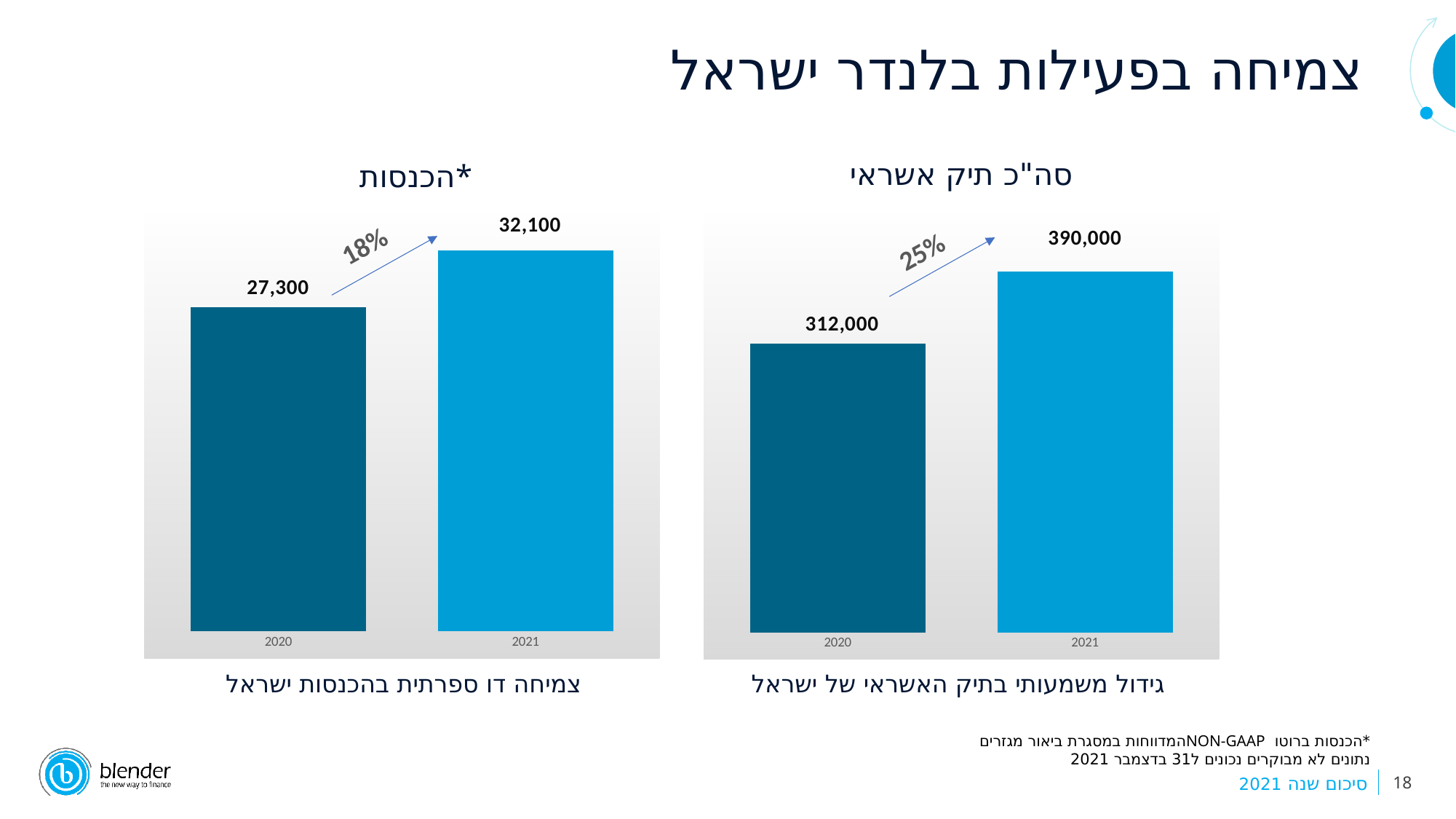
In the right chart (סה"כ תיק אשראי), what is the value for 2020? 312,000 What growth percentage is shown on the arrow in the left chart (הכנסות*)? 18% What type of chart is the right chart (סה"כ תיק אשראי)? Bar chart In the left chart (הכנסות*), how many bars are plotted? 2 In the left chart (הכנסות*), what is the value for 2021? 32,100 In the left chart (הכנסות*), what is the difference between the 2021 and 2020 values? 4,800 In the left chart (הכנסות*), which year has the lower value? 2020 In the right chart (סה"כ תיק אשראי), do the values rise or fall from 2020 to 2021? Rise In the right chart (סה"כ תיק אשראי), what is the difference between the 2021 and 2020 values? 78,000 In the right chart (סה"כ תיק אשראי), which year has the higher value? 2021 In the left chart (הכנסות*), what is the value for 2020? 27,300 In the right chart (סה"כ תיק אשראי), what is the value for 2021? 390,000